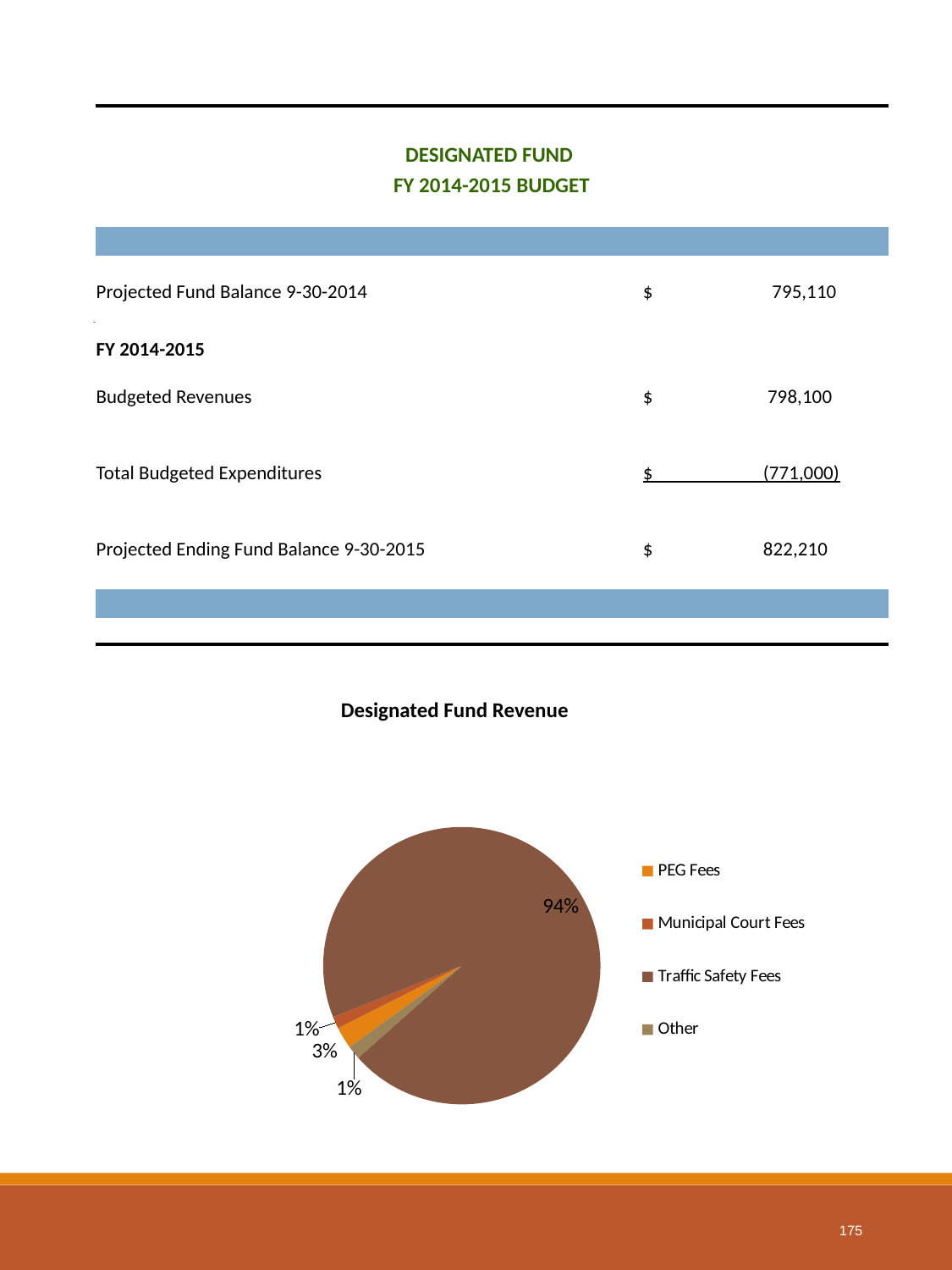
What colour represents Traffic Safety Fees in the Designated Fund Revenue chart? brown What percentage is shown for PEG Fees in the Designated Fund Revenue chart? 3% What share of the Designated Fund Revenue pie is Traffic Safety Fees? 94% In the Designated Fund Revenue chart, how many percentage points larger is Traffic Safety Fees than PEG Fees? 91 How many slices does the Designated Fund Revenue pie chart have? 4 What percentage is shown for Other in the Designated Fund Revenue chart? 1% What is the title of the pie chart on the slide? Designated Fund Revenue Which category has the largest share in the Designated Fund Revenue pie chart? Traffic Safety Fees In the Designated Fund Revenue chart, which is larger: Traffic Safety Fees or PEG Fees? Traffic Safety Fees What kind of chart is the Designated Fund Revenue chart? pie chart How many entries does the legend of the Designated Fund Revenue chart list? 4 What percentage is shown for Municipal Court Fees in the Designated Fund Revenue chart? 1%